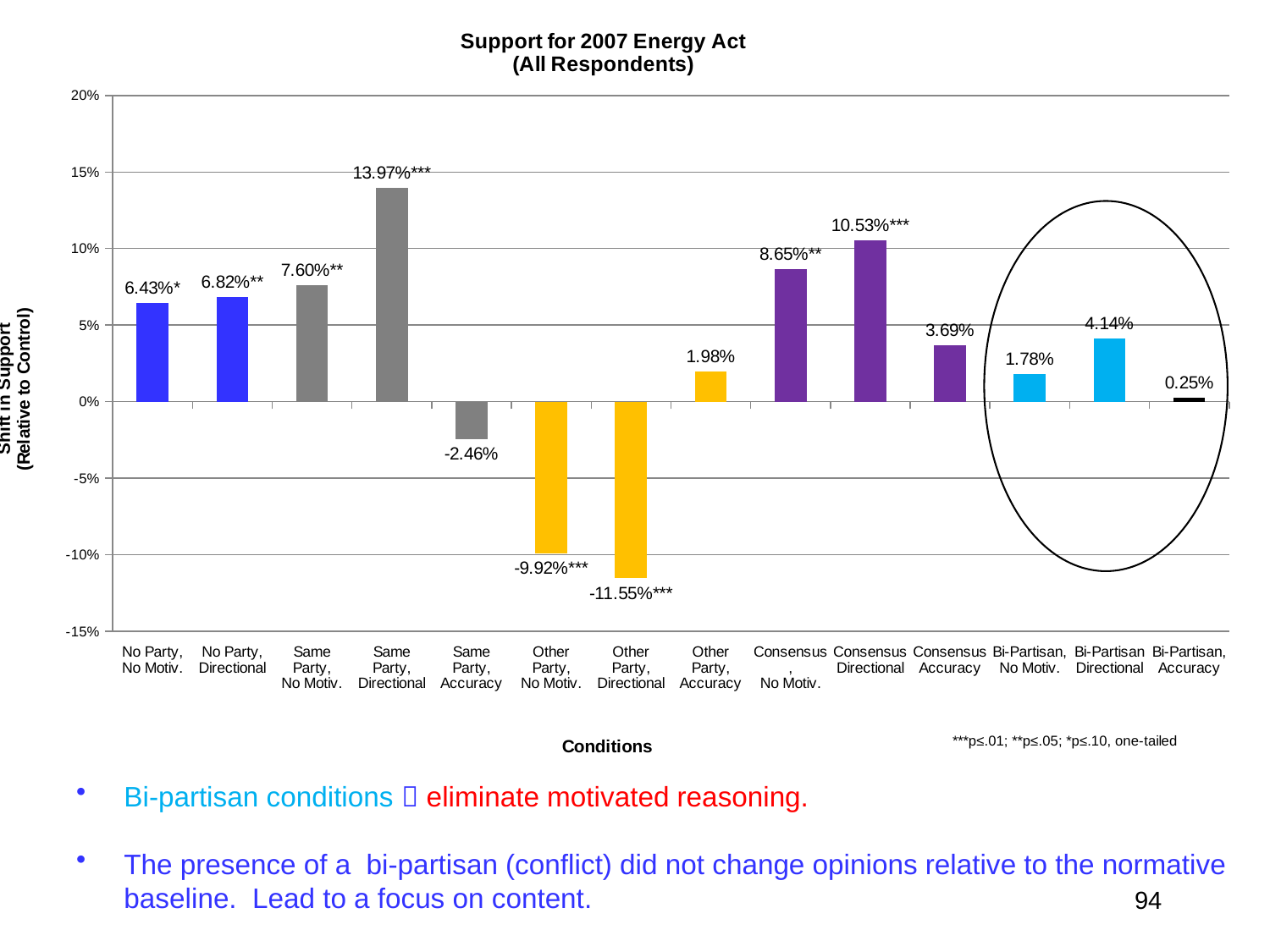
Which is larger, the value for Consensus, Directional or the value for No Party, Directional? Consensus, Directional What is the difference between the Bi-Partisan, Directional value and the Bi-Partisan, No Motiv. value? 2.36% What is the title of the chart? Support for 2007 Energy Act (All Respondents) What is the value shown for the Same Party, Directional condition? 13.97%*** Is the value for Same Party, Directional greater or less than 10%? greater What kind of chart is shown on the slide? Bar chart Which condition has the lowest shift in support? Other Party, Directional Which condition has the highest shift in support? Same Party, Directional What is the value shown for the Bi-Partisan, Accuracy condition? 0.25% How many conditions are plotted on the x axis? 14 What is the value shown for the Other Party, No Motiv. condition? -9.92%*** What is the value shown for the Consensus, Accuracy condition? 3.69%